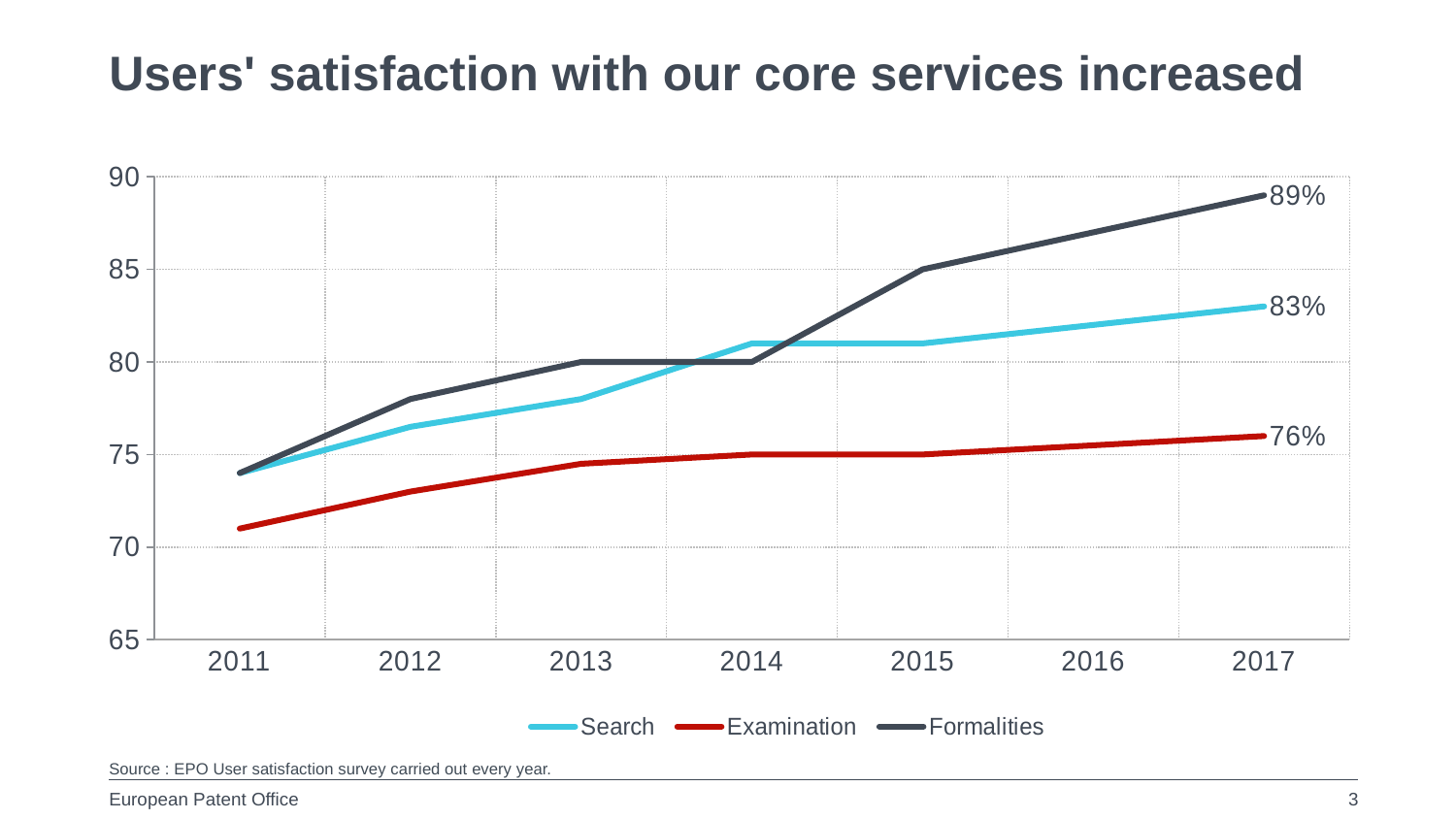
What is the difference between the Formalities and Examination values in 2017? 13 percentage points Which series has the lowest value in 2017? Examination What is the value for Examination in 2017? 76% What is the value for Search in 2017? 83% What kind of chart is shown on the slide? line chart What is the title of the chart? Users' satisfaction with our core services increased How many years are shown on the x axis? 7 Does the Examination series rise or fall from 2011 to 2017? rise What is the value for Formalities in 2017? 89% Which series has the highest value in 2017? Formalities Is the value for Examination in 2011 greater or less than 75? less How many series does the legend list? 3